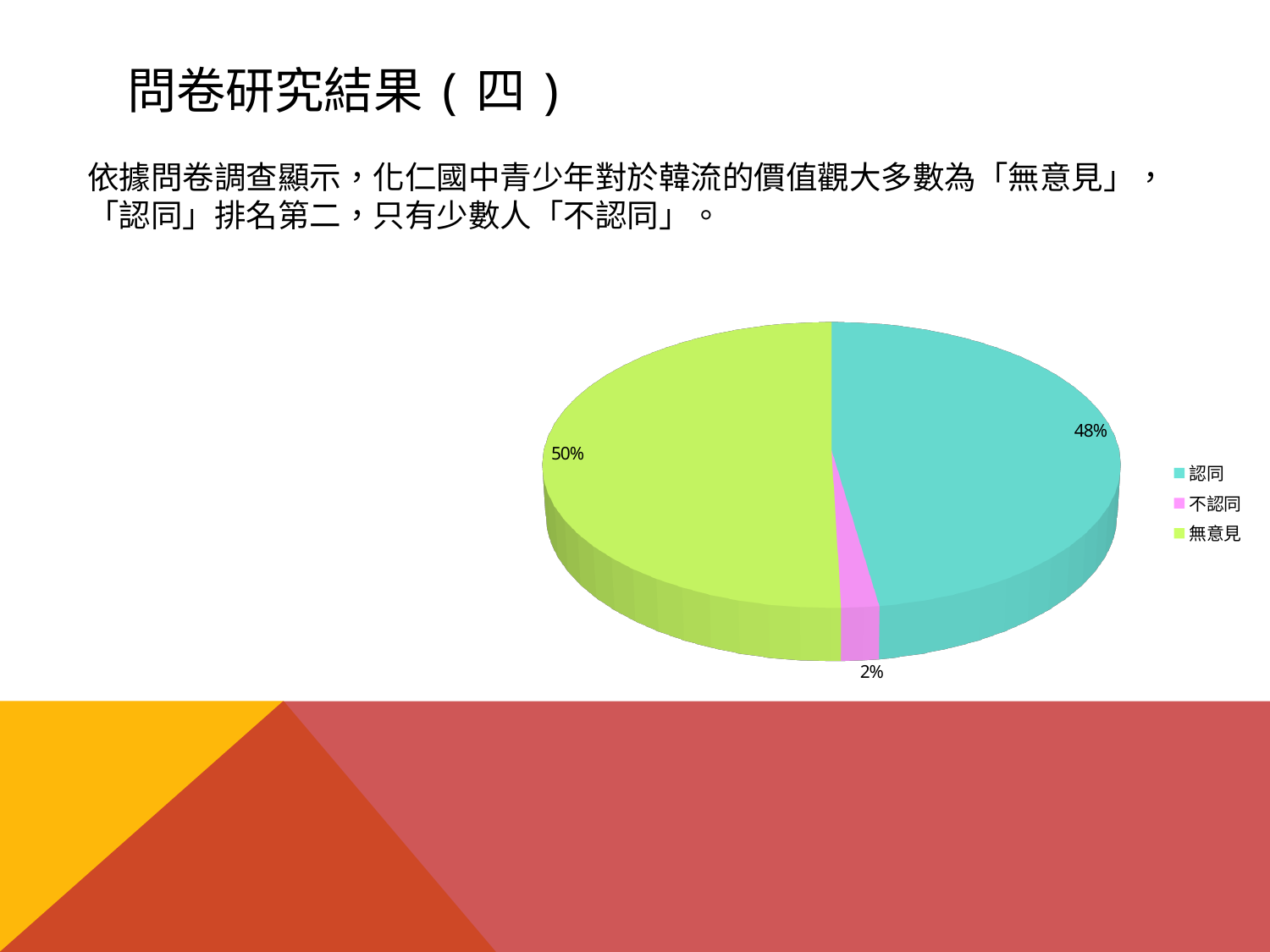
What is the difference in percentage points between 無意見 and 認同? 2% Which is larger, the slice for 認同 or the slice for 不認同? 認同 What share of the pie does 不認同 represent? 2% Which category has the largest slice of the pie? 無意見 What is the difference in percentage points between 認同 and 不認同? 46% What share of the pie does 無意見 represent? 50% How many entries does the legend list? 3 What kind of chart is shown on the slide? pie chart What colour is the slice for 不認同? pink Which category has the smallest slice of the pie? 不認同 How many categories are shown in the pie chart? 3 What share of the pie does 認同 represent? 48%